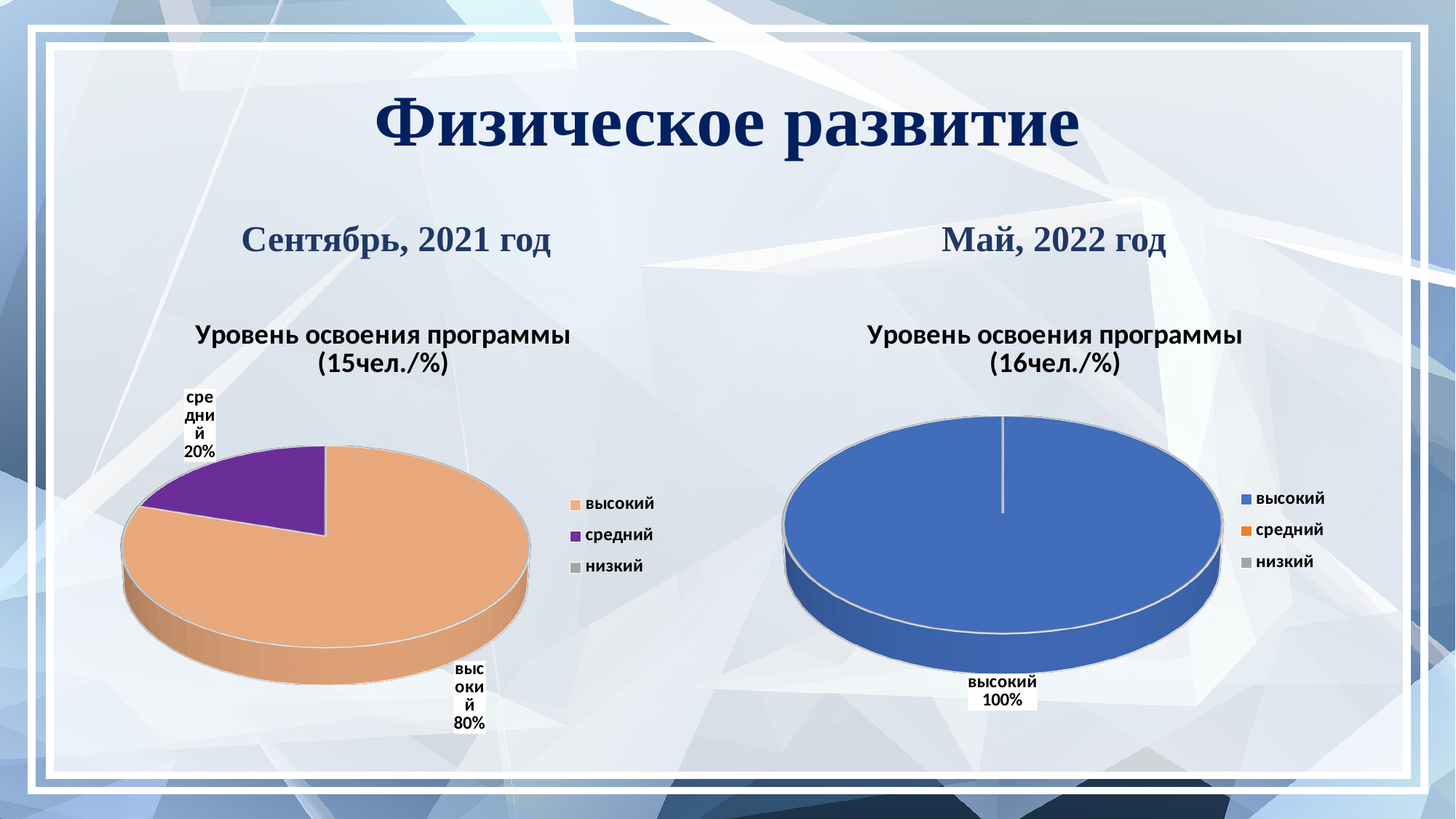
How many entries does the legend of the right chart (Май, 2022 год) list? 3 What type of chart is used on the right side of the slide (Май, 2022 год)? Pie chart How many slices with data labels are visible in the left chart (Сентябрь, 2021 год)? 2 In the right chart (Май, 2022 год), what share of the pie is labelled высокий? 100% In the left chart (Сентябрь, 2021 год), which category has the largest slice? высокий In the left chart (Сентябрь, 2021 год), what colour is the средний slice? Purple In the left chart (Сентябрь, 2021 год), what share of the pie is labelled высокий? 80% What is the title of the right chart (Май, 2022 год)? Уровень освоения программы (16чел./%) In the left chart (Сентябрь, 2021 год), what is the difference between the высокий and средний shares? 60% In the left chart (Сентябрь, 2021 год), what share of the pie is labelled средний? 20% In the left chart (Сентябрь, 2021 год), which is larger, the высокий slice or the средний slice? высокий What type of chart is used on the left side of the slide (Сентябрь, 2021 год)? Pie chart